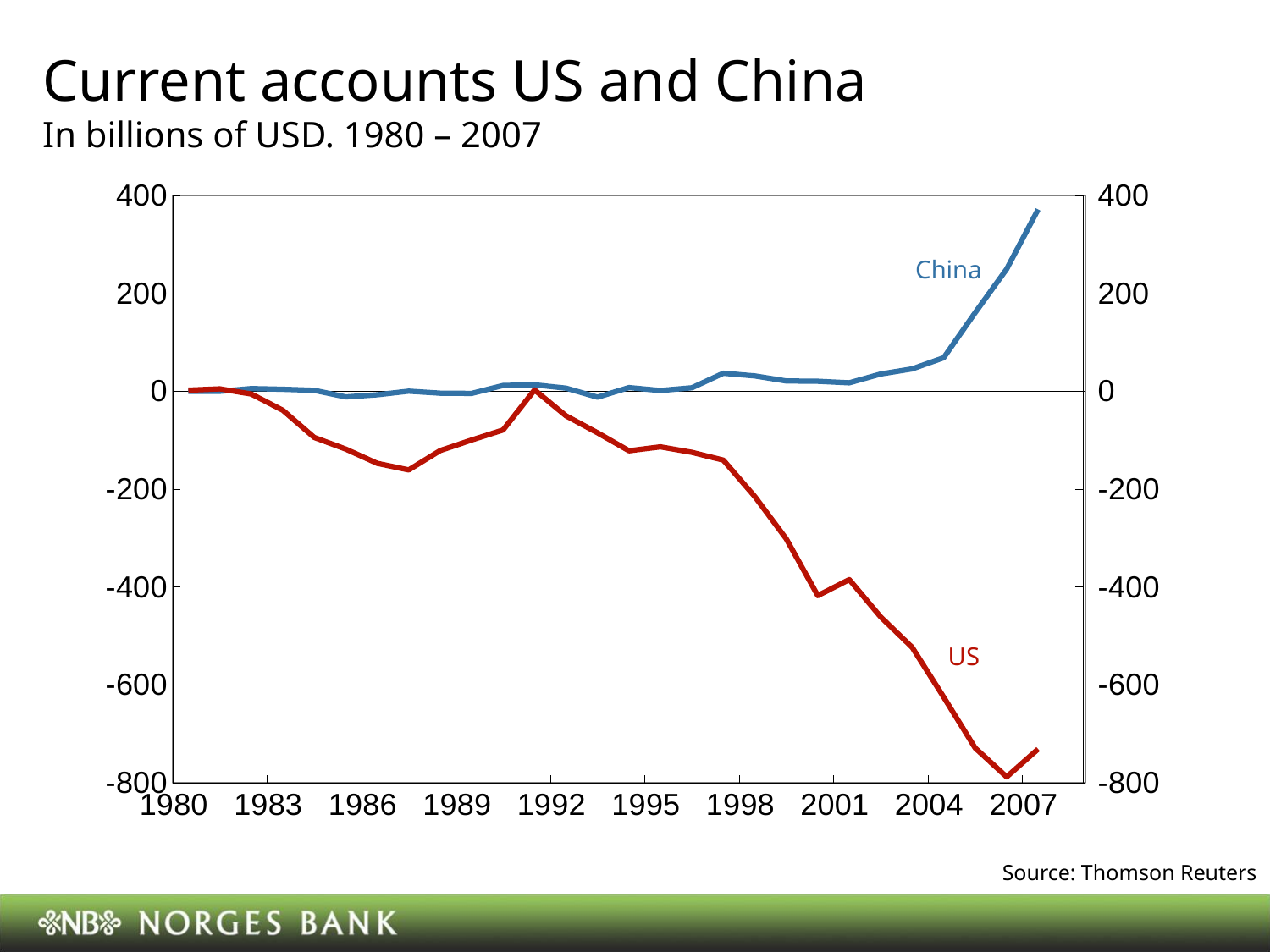
Is the value for China in 2004 greater or less than 200? less What is the source cited for the chart? Thomson Reuters What is the title of the chart on the slide? Current accounts US and China Is the value for the US in 2001 greater or less than -200? less Does the US line rise or fall over the period from 1998 to 2006? Fall What kind of chart is shown on the slide? Line chart Which series reaches the highest value on the chart? China Does the China line rise or fall over the period from 2001 to 2007? Rise Is the value for China in 2007 greater or less than 200? greater How many series are plotted on the chart? 2 In 2007, which series has the larger value, China or the US? China